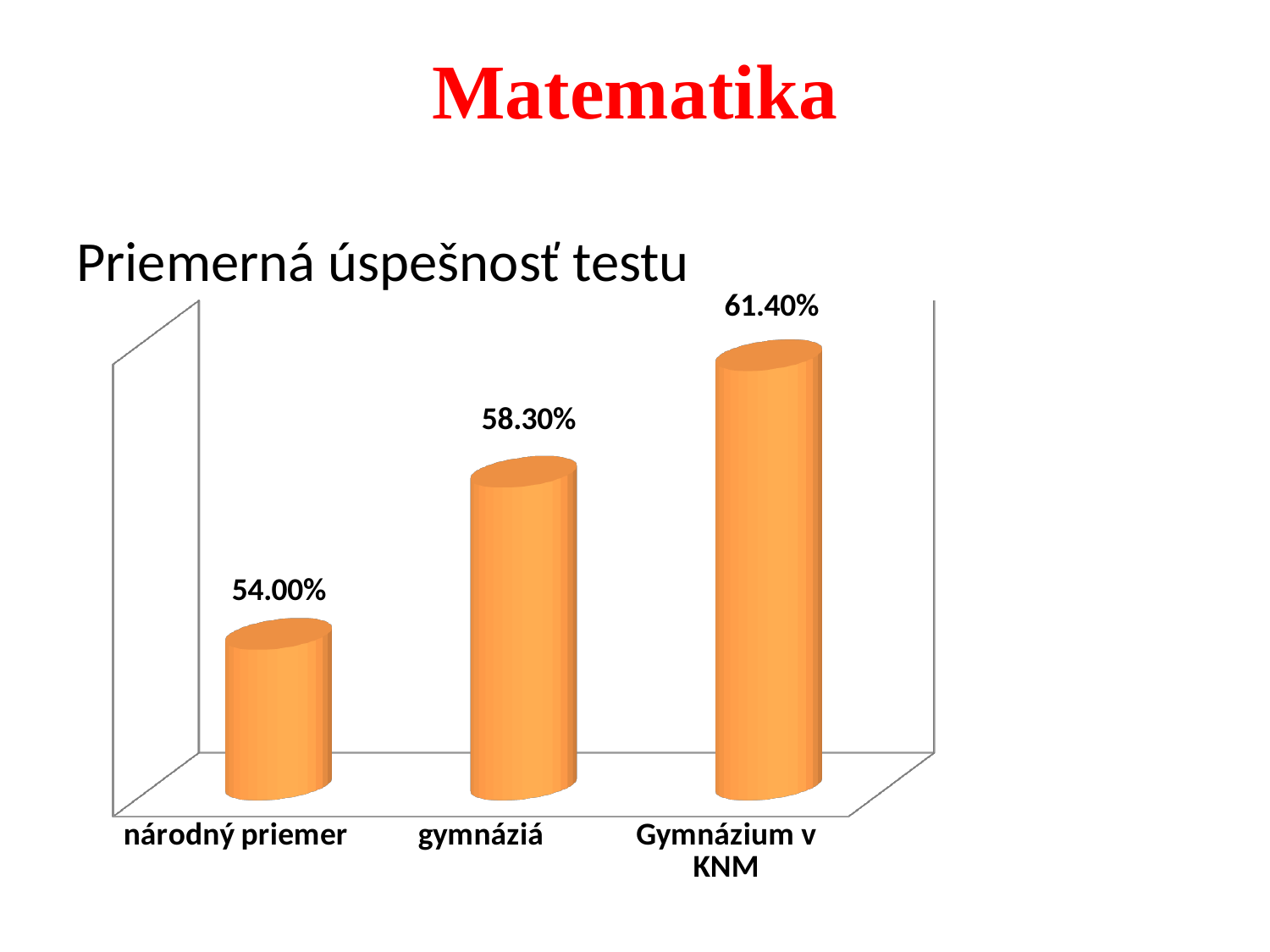
What is the value for Gymnázium v KNM? 61.40% What is the difference between the values for gymnáziá and národný priemer? 4.30% How many categories are shown in the chart? 3 Which is larger, the value for gymnáziá or the value for Gymnázium v KNM? Gymnázium v KNM Which category has the highest value? Gymnázium v KNM Do the values rise or fall from left to right across the categories? rise What is the value for národný priemer? 54.00% What is the value for gymnáziá? 58.30% What kind of chart is shown on the slide? bar chart What is the title of the chart? Priemerná úspešnosť testu Which category has the lowest value? národný priemer What is the difference between the values for Gymnázium v KNM and národný priemer? 7.40%